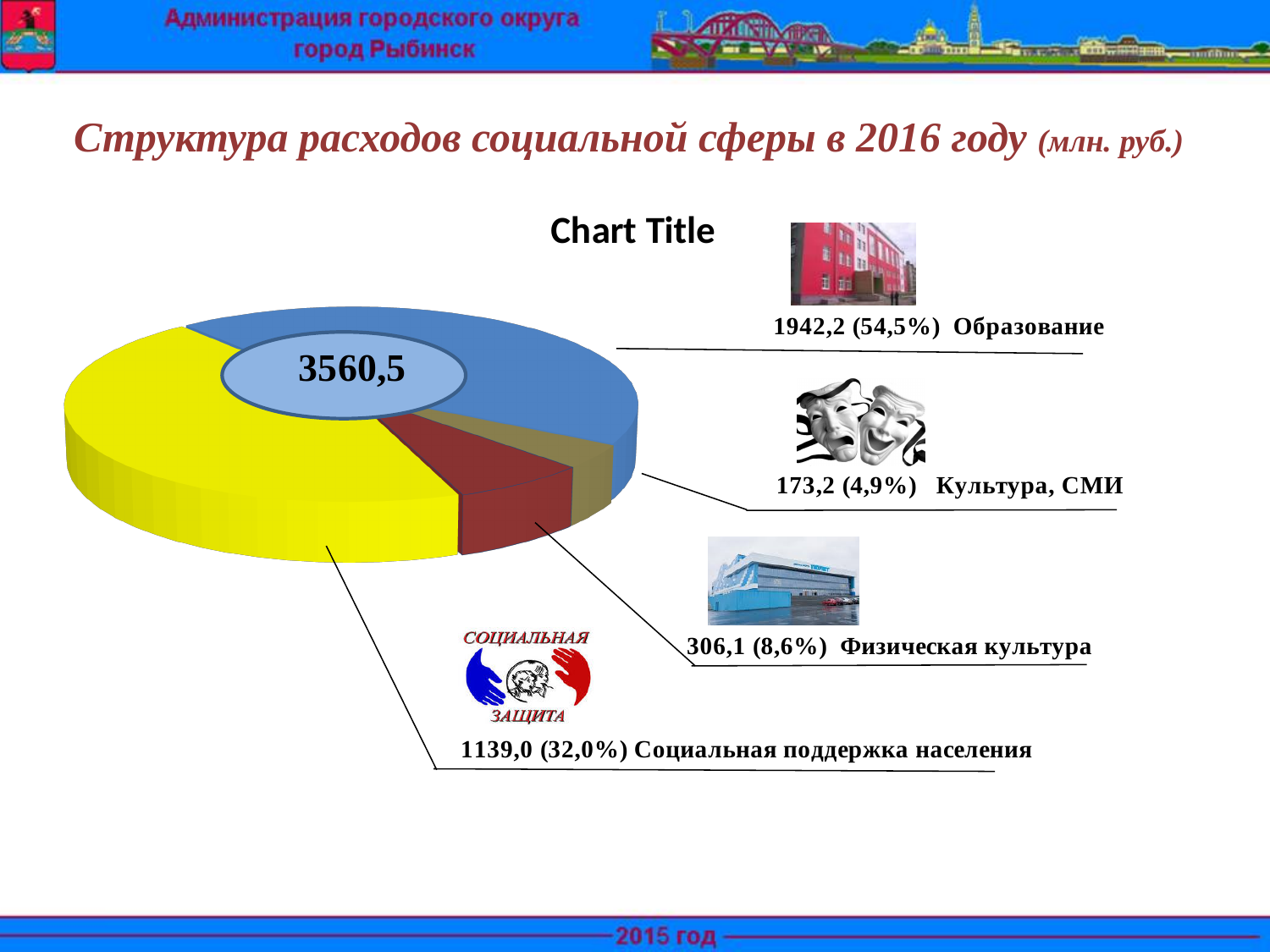
Which category has the smallest value? Культура, СМИ What is the value for Культура, СМИ? 173,2 What kind of chart is shown on the slide? pie chart Which category has the largest value? Образование What is the difference between the values for Физическая культура and Культура, СМИ? 132,9 What is the value for Физическая культура? 306,1 What is the value for Образование? 1942,2 What total value is shown in the centre of the pie chart? 3560,5 What share of the pie does Социальная поддержка населения represent? 32,0% What share of the pie does Образование represent? 54,5% How many slices does the pie chart have? 4 What is the value for Социальная поддержка населения? 1139,0